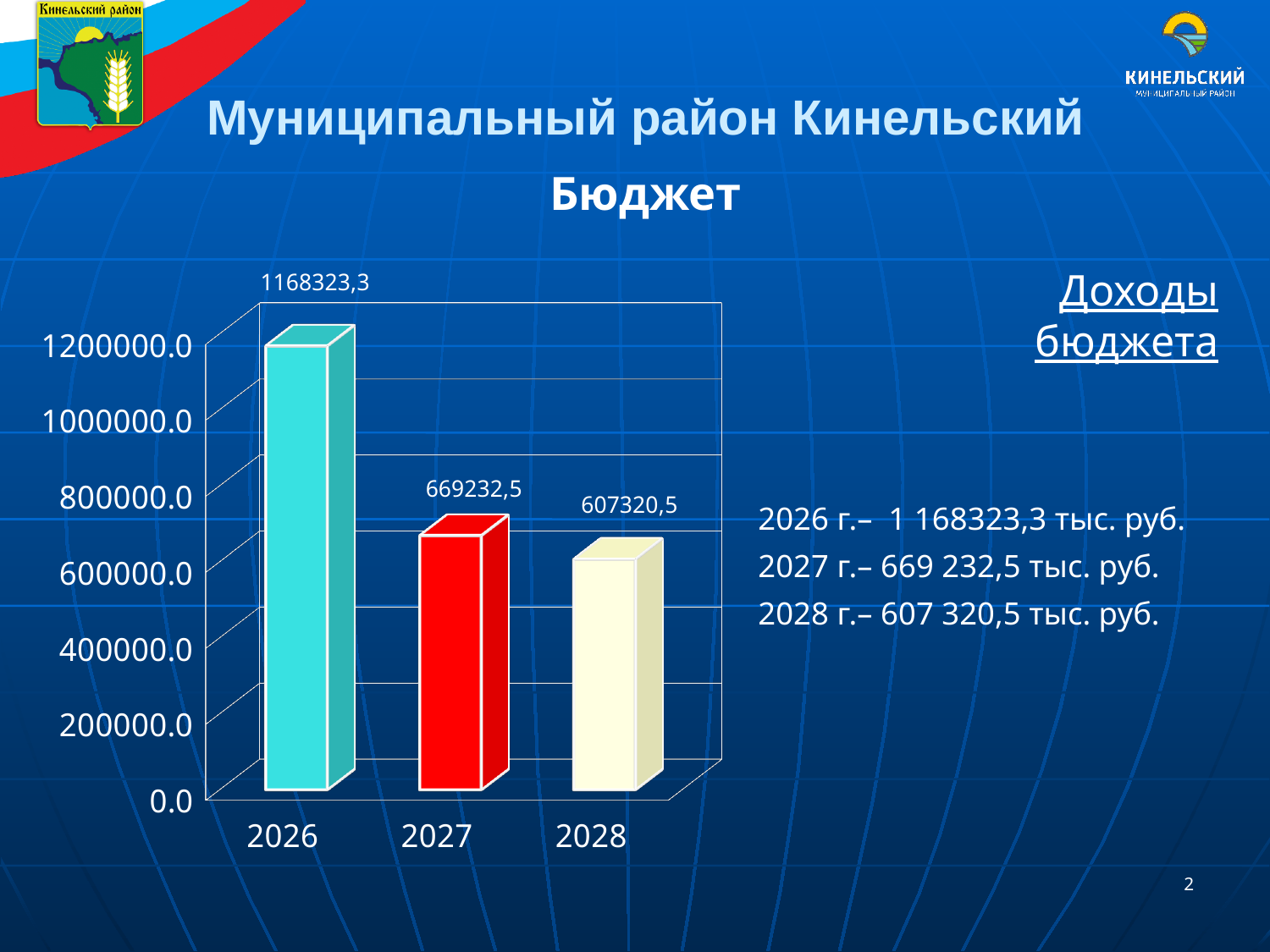
What is the value shown for 2026? 1168323,3 Is the value for 2026 greater or less than 1000000.0? greater What is the difference between the values for 2026 and 2027? 499090,8 What is the value shown for 2028? 607320,5 What is the value shown for 2027? 669232,5 Do the values rise or fall from 2026 to 2028? fall What is the difference between the values for 2027 and 2028? 61912,0 Which year has the lowest value? 2028 How many years are shown on the x axis? 3 What kind of chart is shown? bar chart Which is larger, the value for 2027 or the value for 2028? 2027 Which year has the highest value? 2026